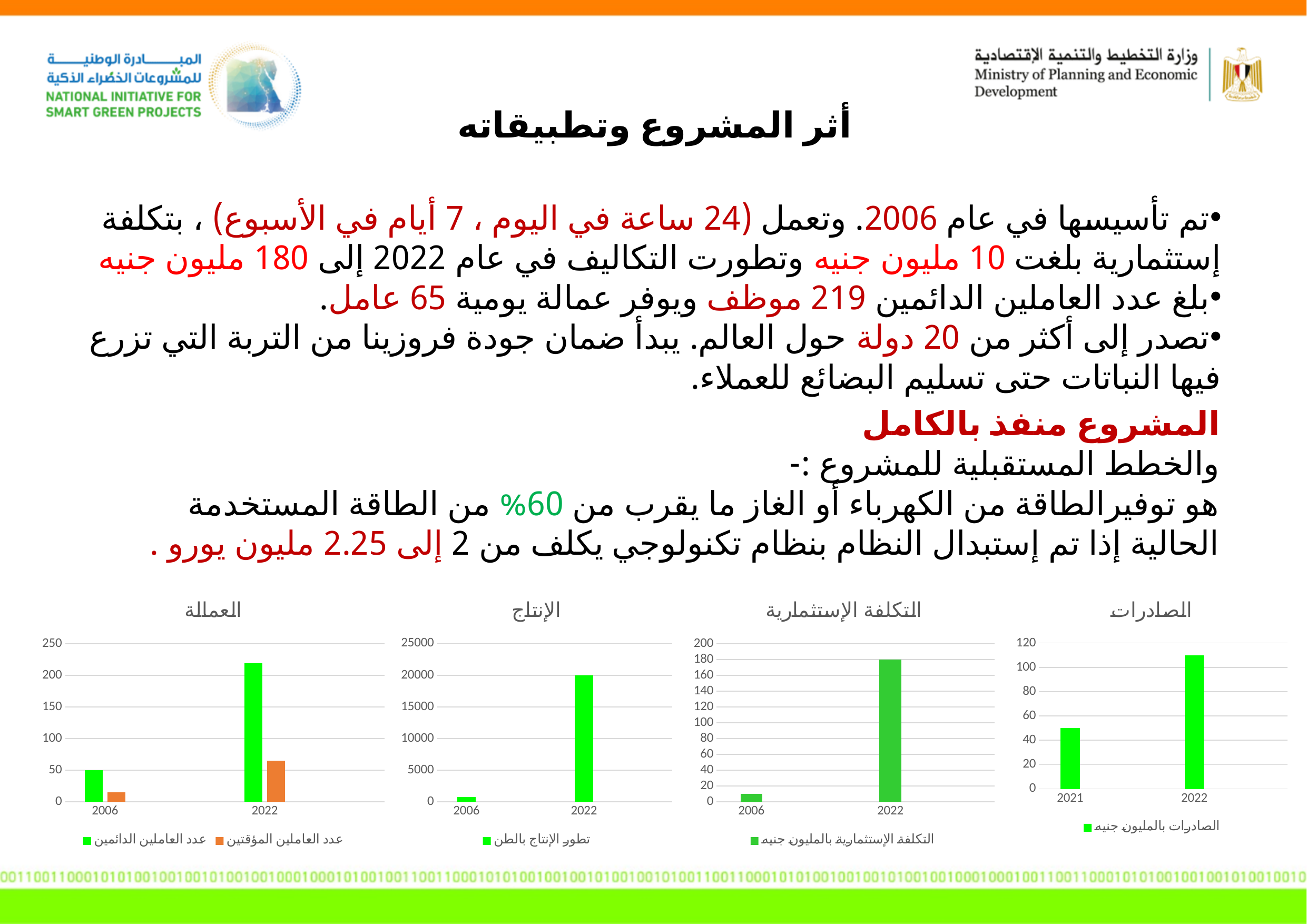
In the الصادرات chart, do the values rise or fall from 2021 to 2022? rise In the التكلفة الإستثمارية chart, what is the value for 2022? 180 In the العمالة chart, is the value for عدد العاملين الدائمين in 2022 greater or less than 200? greater How many series does the legend of the العمالة chart list? 2 What is the legend entry of the الإنتاج chart? تطور الإنتاج بالطن Which years are shown on the x axis of the الصادرات chart? 2021 and 2022 In the العمالة chart, which year has the higher value for عدد العاملين المؤقتين? 2022 What kind of chart is the الصادرات chart? bar chart In the الإنتاج chart, what is the value for 2022? 20000 How many categories are shown on the x axis of the الإنتاج chart? 2 In the التكلفة الإستثمارية chart, is the value for 2006 greater or less than 20? less In the الصادرات chart, is the value for 2022 greater or less than 100? greater